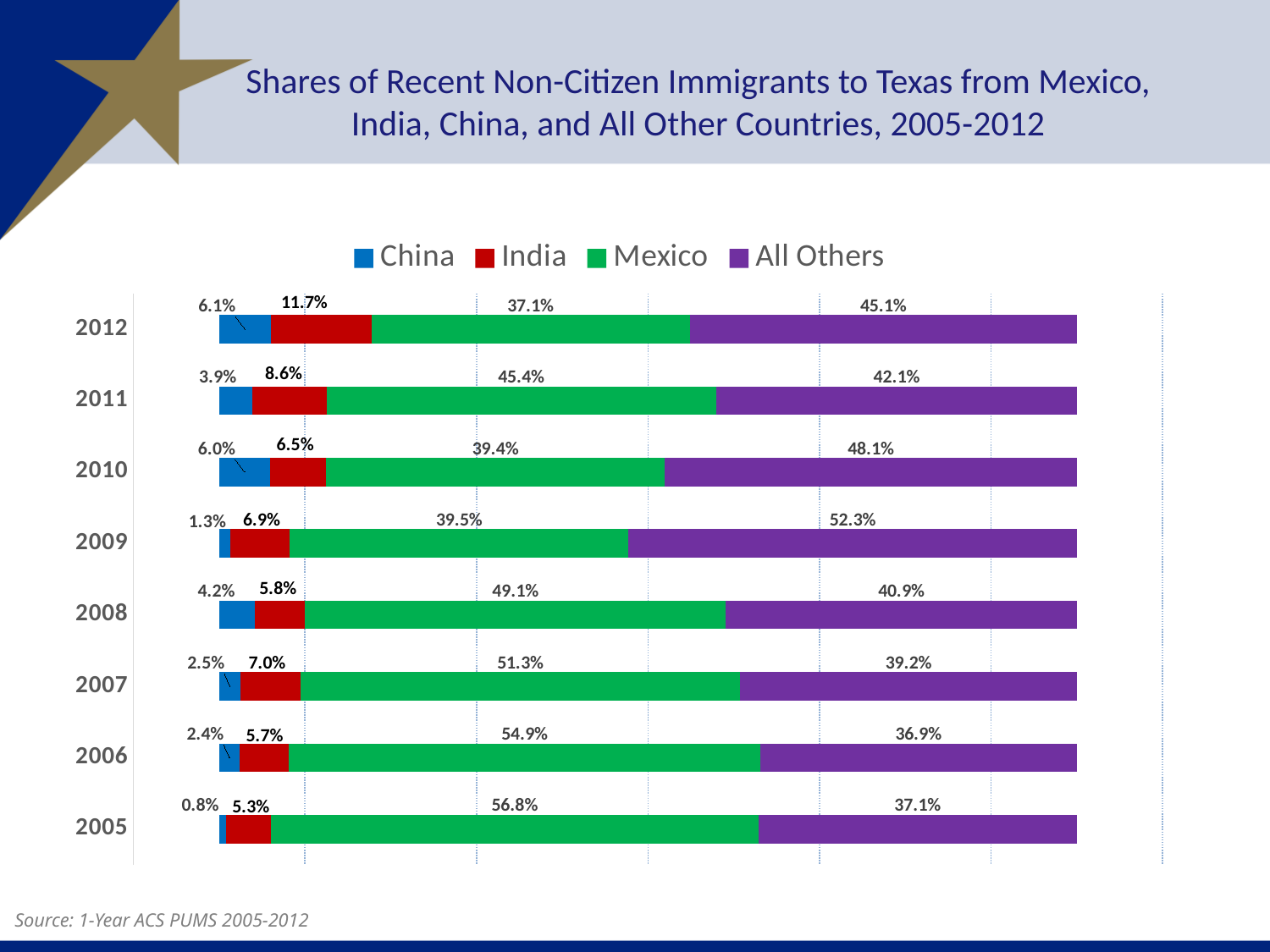
What is the India share shown for 2012? 11.7% Which is larger in 2011, the Mexico share or the All Others share? Mexico How many series does the legend list? 4 In which year is the Mexico share the highest? 2005 How many years are shown on the chart? 8 What is the All Others share shown for 2009? 52.3% By how many percentage points did the India share change from 2005 to 2012? 6.4 percentage points In which year is the All Others share the highest? 2009 What kind of chart is shown on the slide? Stacked bar chart What share of recent non-citizen immigrants to Texas came from Mexico in 2005? 56.8% In which year is the China share the lowest? 2005 Does the Mexico share generally rise or fall from 2005 to 2012? Fall